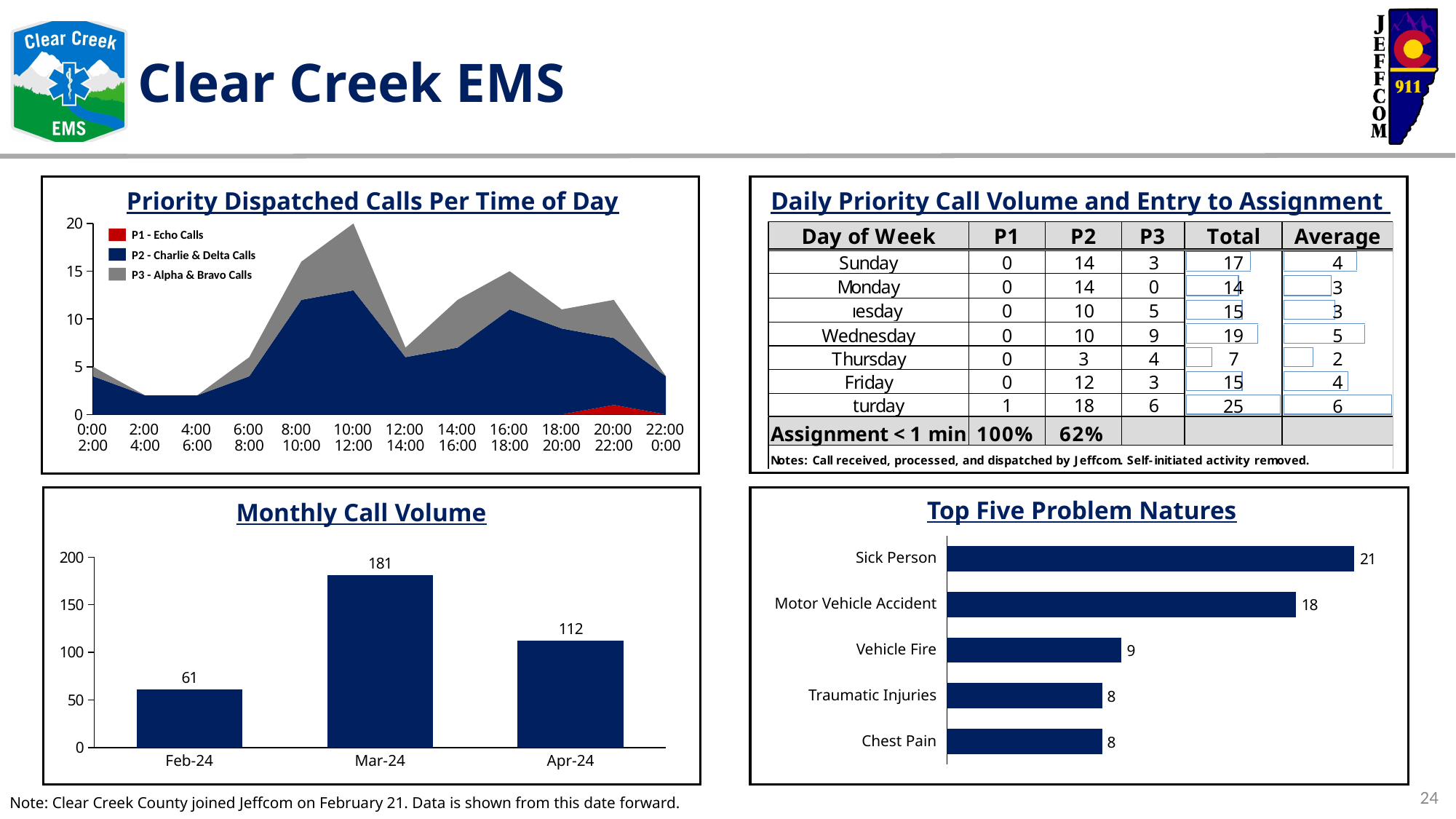
In the Top Five Problem Natures chart, what is the difference between Sick Person and Vehicle Fire? 12 In the Monthly Call Volume chart, what is the difference between the Mar-24 and Apr-24 values? 69 In the Top Five Problem Natures chart, what is the value for Motor Vehicle Accident? 18 In the Top Five Problem Natures chart, which problem nature has the highest value? Sick Person In the Priority Dispatched Calls Per Time of Day chart, is the total value for the 10:00-12:00 period greater or less than 15? greater In the Monthly Call Volume chart, how many months are shown? 3 In the Monthly Call Volume chart, what is the value for Feb-24? 61 In the Monthly Call Volume chart, which month has the lowest call volume? Feb-24 In the Monthly Call Volume chart, what is the value for Mar-24? 181 In the Top Five Problem Natures chart, which is larger, Vehicle Fire or Traumatic Injuries? Vehicle Fire In the Priority Dispatched Calls Per Time of Day chart, how many series does the legend list? 3 In the Monthly Call Volume chart, which month has the highest call volume? Mar-24